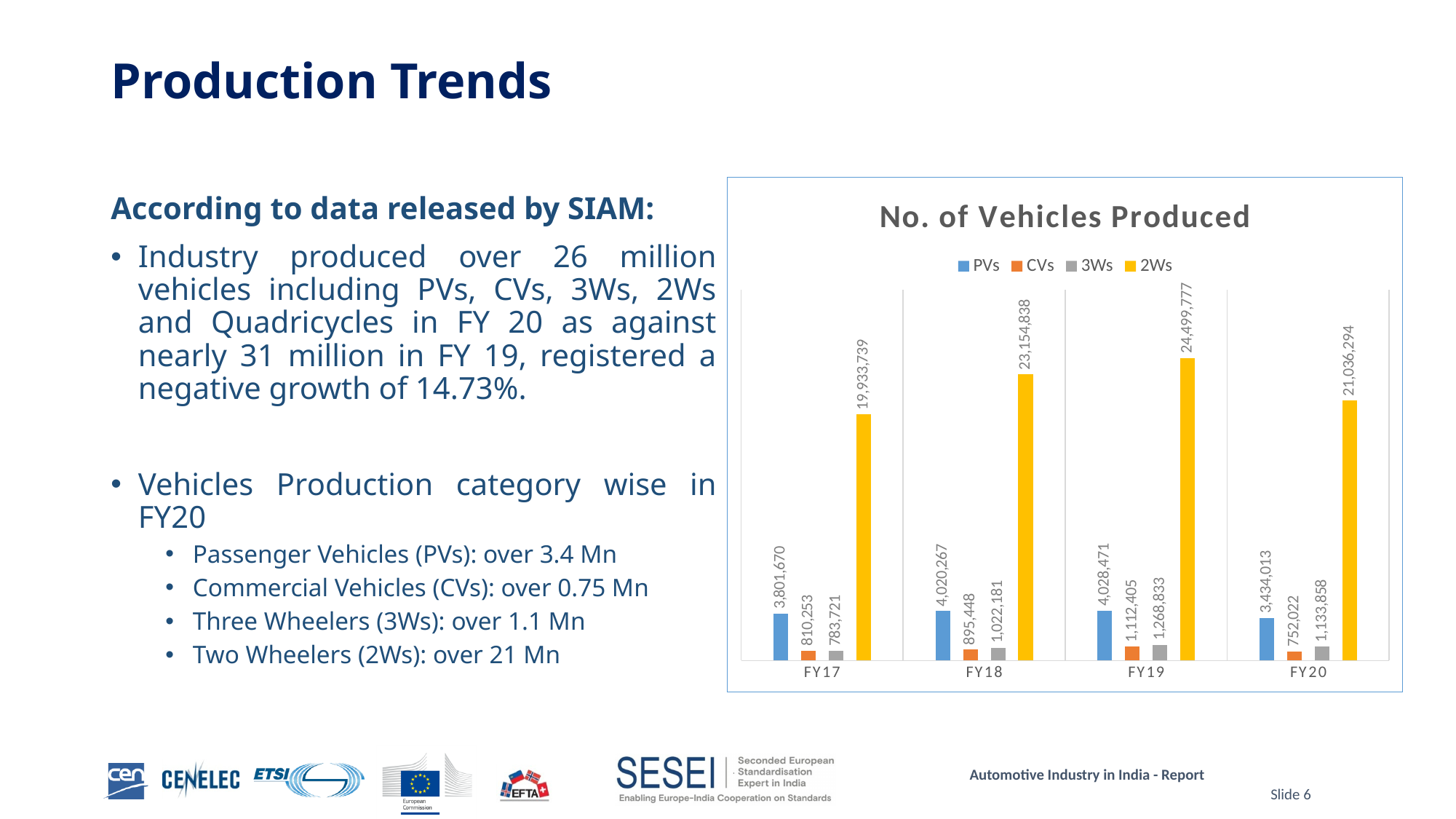
In FY20, which is larger in the chart: 3Ws or CVs? 3Ws What is the value for 2Ws in FY19 in the No. of Vehicles Produced chart? 24,499,777 How many series does the legend of the chart list? 4 How many fiscal years are shown on the x axis of the chart? 4 What is the value for CVs in FY17 in the chart? 810,253 What is the difference between the 2Ws values for FY19 and FY20 in the chart? 3,463,483 How many PVs were produced in FY20 according to the chart? 3,434,013 What kind of chart is the No. of Vehicles Produced chart? Bar chart In which fiscal year is the PVs value lowest in the chart? FY20 What is the difference between the CVs values for FY19 and FY20 in the chart? 360,383 What is the value for 3Ws in FY18 in the chart? 1,022,181 In which fiscal year is the 2Ws value highest in the chart? FY19